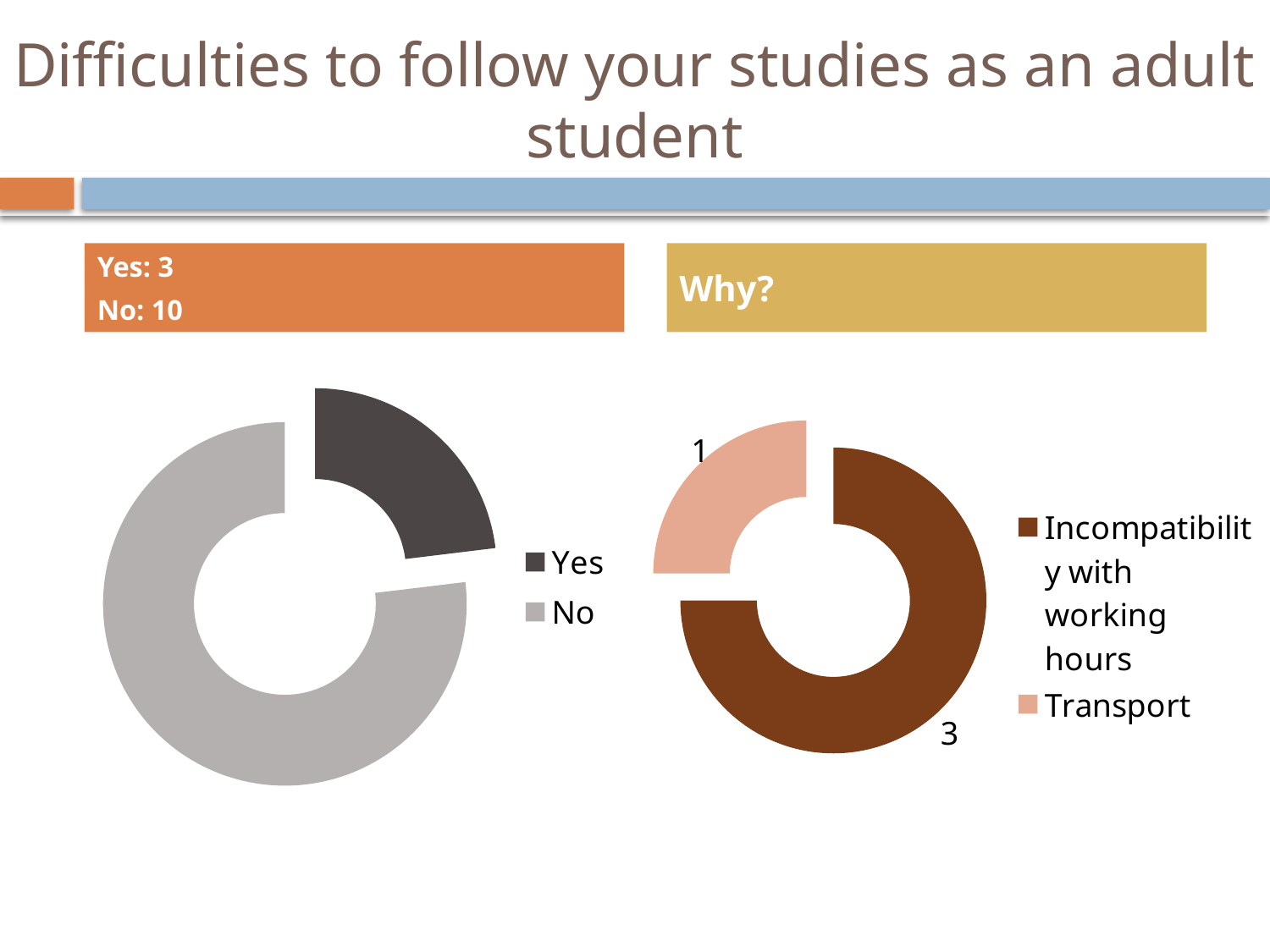
In the right chart under 'Why?', which category has the highest value? Incompatibility with working hours In the left chart, which category is larger, Yes or No? No What kind of chart is the left chart showing Yes and No? Doughnut chart In the right chart under 'Why?', what share of the total does Transport represent? 25% In the left chart, what is the value for No? 10 In the left chart, what is the value for Yes? 3 In the left chart, how many categories does the legend list? 2 In the right chart under 'Why?', what is the difference between Incompatibility with working hours and Transport? 2 In the right chart under 'Why?', what is the value for Transport? 1 In the right chart under 'Why?', what is the value for Incompatibility with working hours? 3 In the left chart, what is the difference between the No and Yes values? 7 In the right chart under 'Why?', which category has the lowest value? Transport